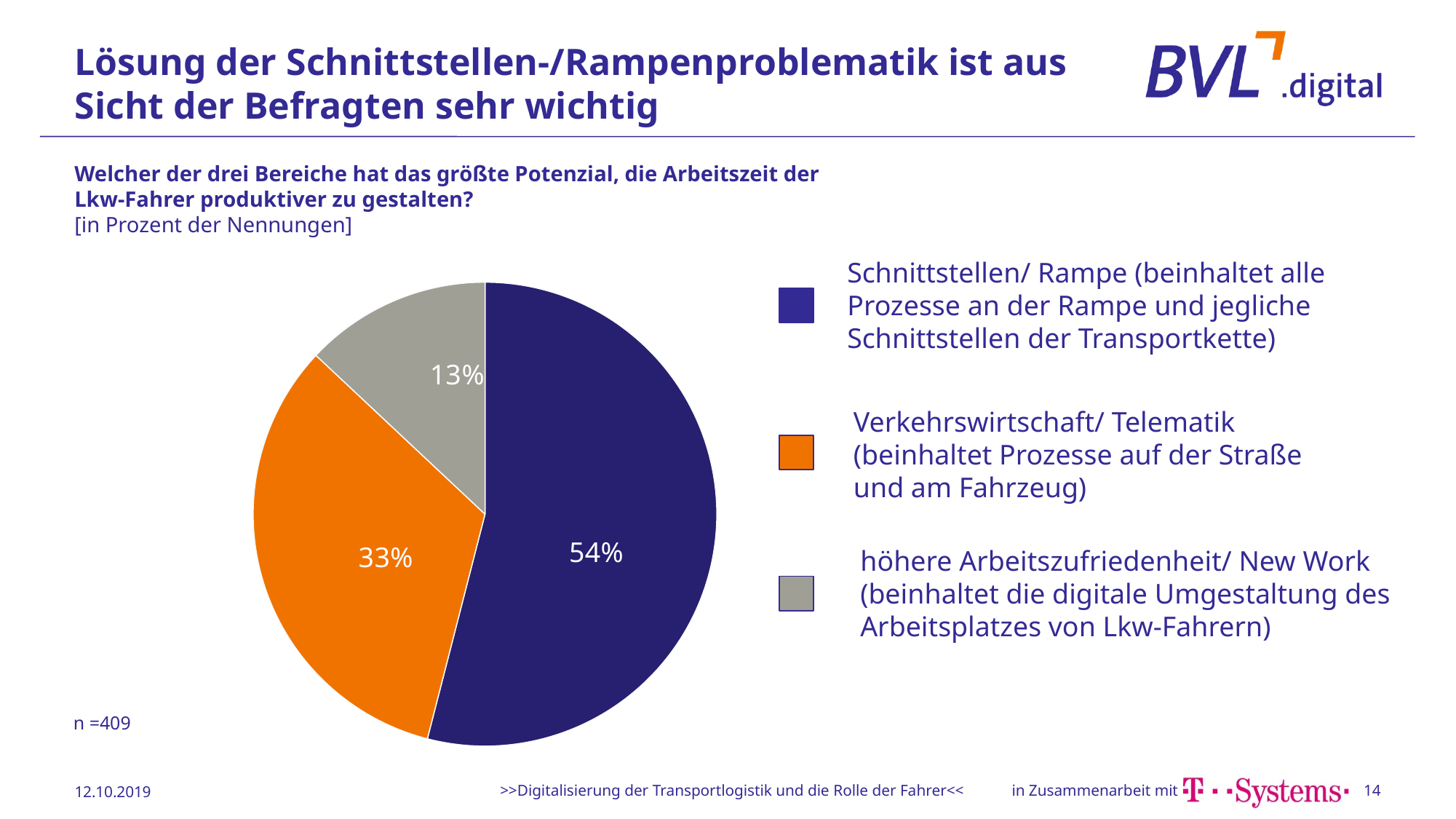
What percentage is shown for Verkehrswirtschaft/ Telematik? 33% What colour is the slice for Verkehrswirtschaft/ Telematik? orange What share of responses does the Schnittstellen/ Rampe slice represent? 54% How many slices does the pie chart have? 3 What is the difference in percentage points between Schnittstellen/ Rampe and Verkehrswirtschaft/ Telematik? 21 Which category has the largest share of the pie? Schnittstellen/ Rampe What type of chart is shown on the slide? pie chart Which category has the smallest share of the pie? höhere Arbeitszufriedenheit/ New Work What is the sample size (n) stated on the slide? 409 What percentage is shown for höhere Arbeitszufriedenheit/ New Work? 13% What is the difference in percentage points between Verkehrswirtschaft/ Telematik and höhere Arbeitszufriedenheit/ New Work? 20 Which is larger: the share for Verkehrswirtschaft/ Telematik or for höhere Arbeitszufriedenheit/ New Work? Verkehrswirtschaft/ Telematik